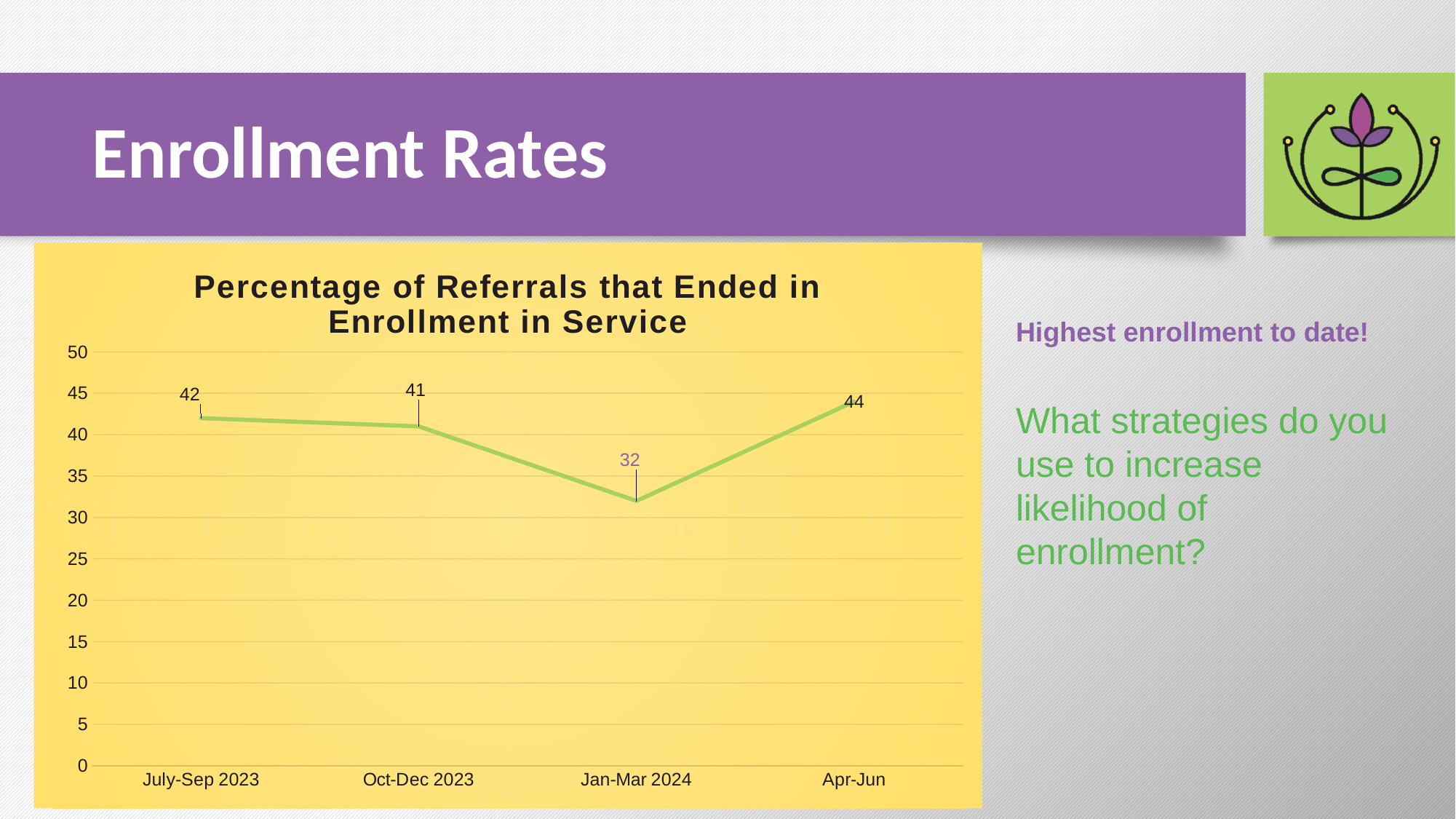
What kind of chart is shown? line chart What is the difference between the values for Apr-Jun and Jan-Mar 2024? 12 What is the value for Jan-Mar 2024? 32 What is the value for July-Sep 2023? 42 What is the title of the chart? Percentage of Referrals that Ended in Enrollment in Service How many periods are plotted on the chart? 4 Which is larger, the value for July-Sep 2023 or the value for Jan-Mar 2024? July-Sep 2023 What is the value for Apr-Jun? 44 Is the value for Oct-Dec 2023 greater or less than 35? greater Does the value rise or fall from Jan-Mar 2024 to Apr-Jun? rise Which period has the highest value? Apr-Jun Which period has the lowest value? Jan-Mar 2024